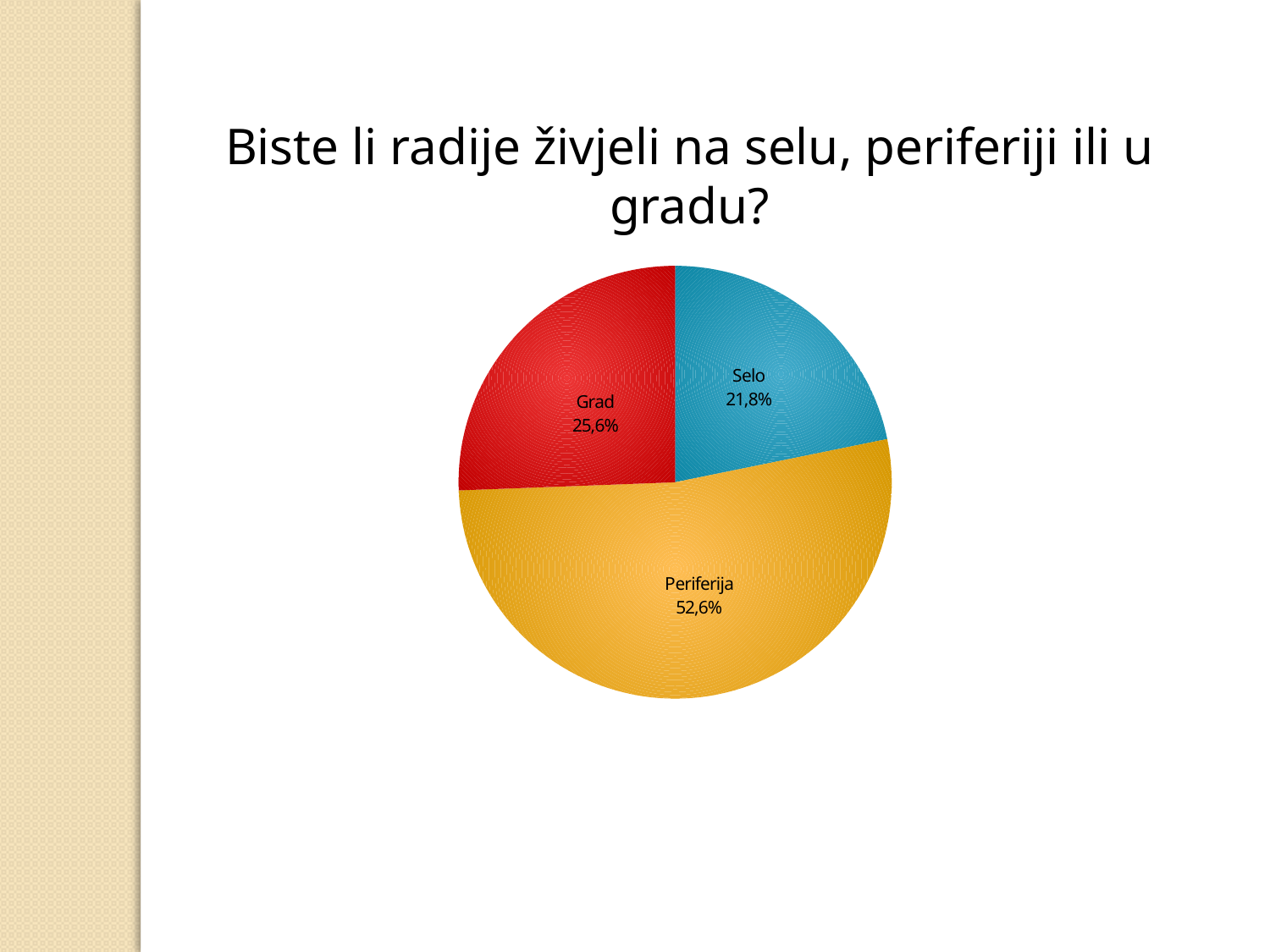
What kind of chart is shown on the slide? Pie chart What is the value shown for Selo? 21,8% What is the value shown for Grad? 25,6% What colour is the slice for Periferija? Yellow Which is larger, the slice for Grad or the slice for Selo? Grad What is the difference between the shares for Grad and Selo? 3,8% What share of the pie does Periferija have? 52,6% What is the difference between the shares for Periferija and Grad? 27,0% How many slices does the pie chart have? 3 What is the title of the chart? Biste li radije živjeli na selu, periferiji ili u gradu? Which category has the largest slice of the pie? Periferija Which category has the smallest slice of the pie? Selo